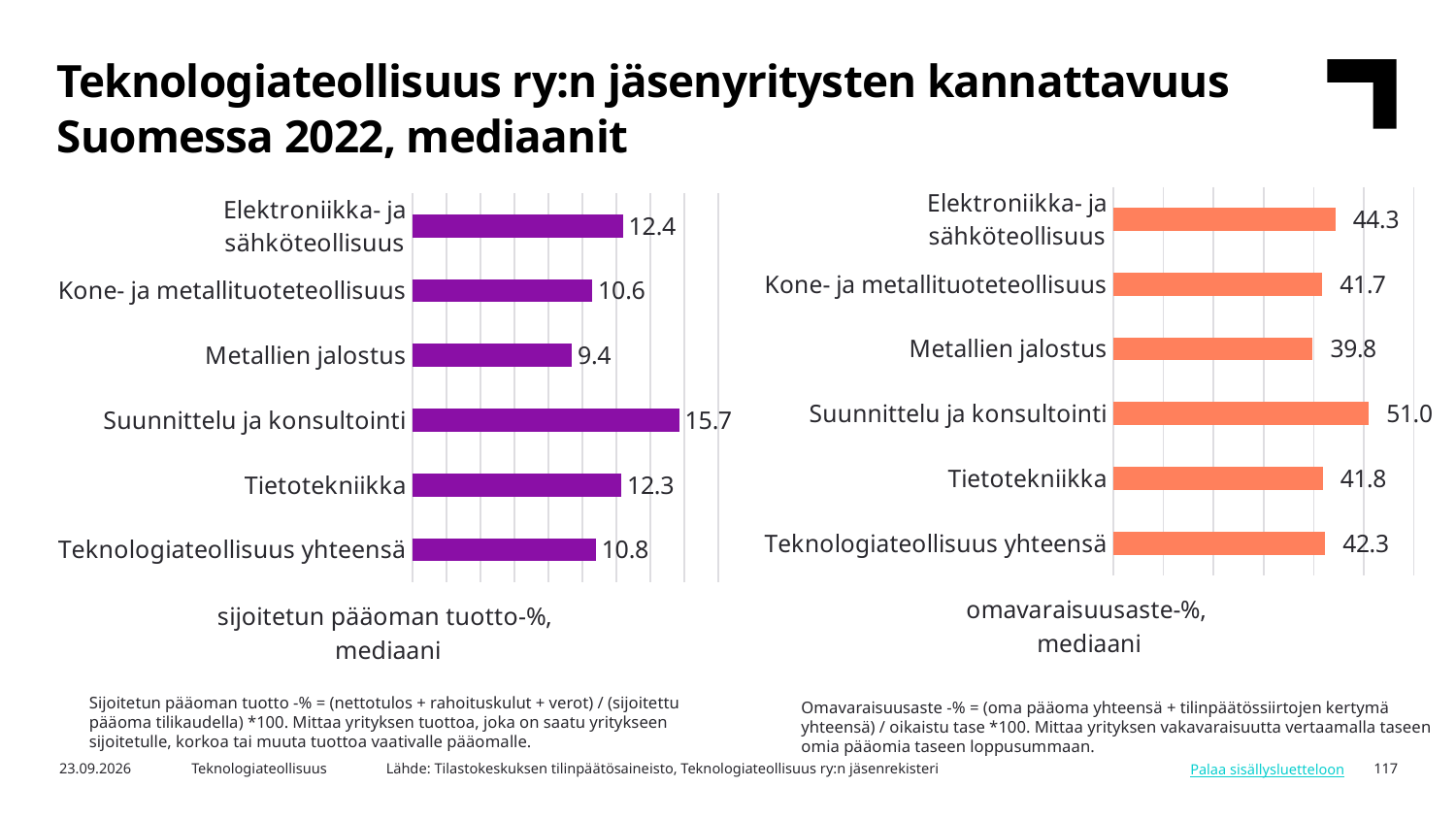
What type of chart is the right chart (omavaraisuusaste-%, mediaani)? Bar chart In the right chart (omavaraisuusaste-%, mediaani), what is the value for Metallien jalostus? 39.8 In the right chart (omavaraisuusaste-%, mediaani), what is the difference between Suunnittelu ja konsultointi and Teknologiateollisuus yhteensä? 8.7 In the left chart (sijoitetun pääoman tuotto-%, mediaani), which category has the highest value? Suunnittelu ja konsultointi In the left chart (sijoitetun pääoman tuotto-%, mediaani), what is the value for Teknologiateollisuus yhteensä? 10.8 In the right chart (omavaraisuusaste-%, mediaani), which category has the highest value? Suunnittelu ja konsultointi In the left chart (sijoitetun pääoman tuotto-%, mediaani), which category has the lowest value? Metallien jalostus How many categories are shown in the left chart (sijoitetun pääoman tuotto-%, mediaani)? 6 In the right chart (omavaraisuusaste-%, mediaani), what is the value for Elektroniikka- ja sähköteollisuus? 44.3 In the left chart (sijoitetun pääoman tuotto-%, mediaani), what is the value for Suunnittelu ja konsultointi? 15.7 In the right chart (omavaraisuusaste-%, mediaani), which is larger: Kone- ja metallituoteteollisuus or Teknologiateollisuus yhteensä? Teknologiateollisuus yhteensä In the left chart (sijoitetun pääoman tuotto-%, mediaani), what is the difference between Suunnittelu ja konsultointi and Metallien jalostus? 6.3